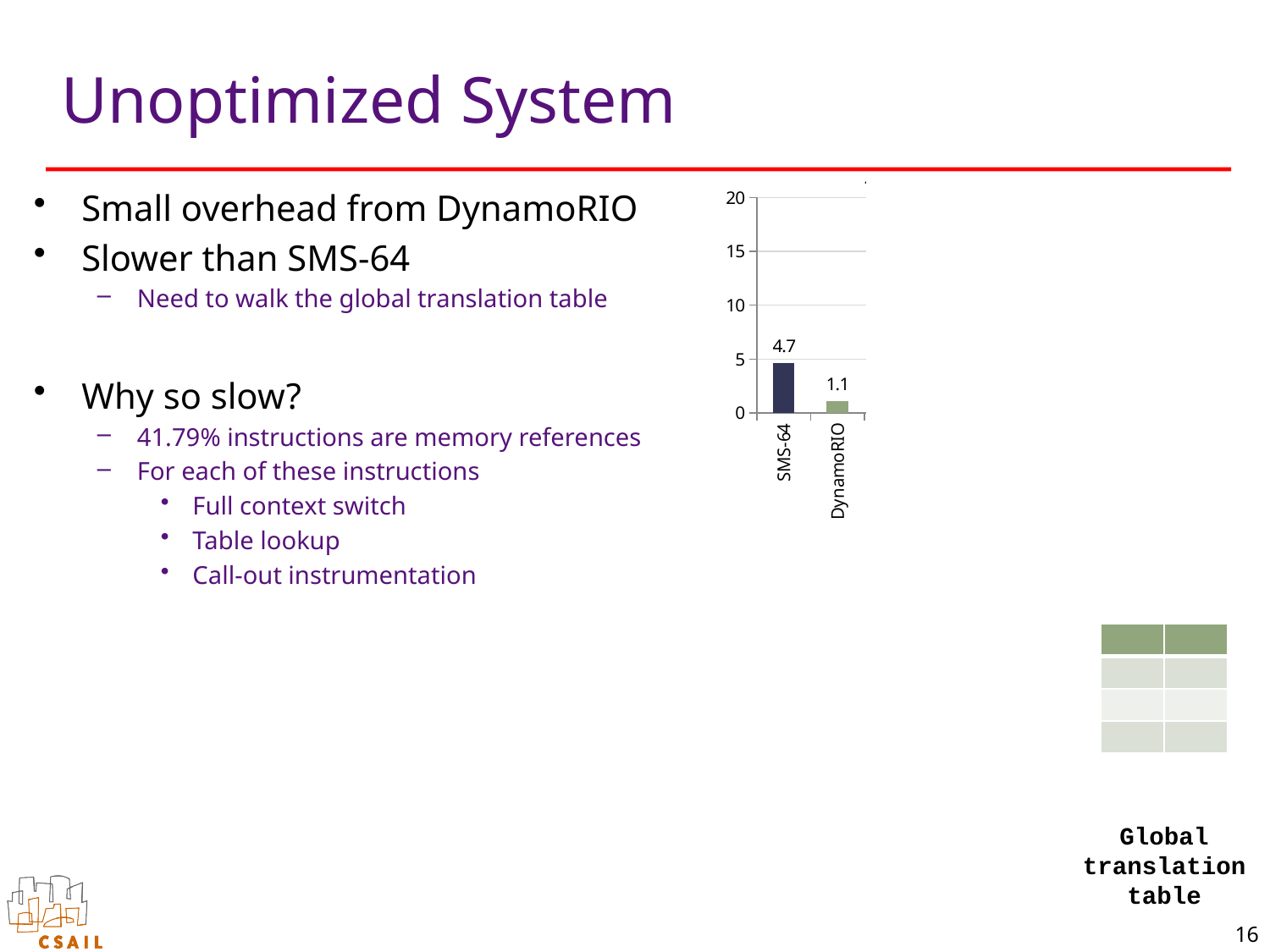
What is the difference between the values for SMS-64 and DynamoRIO? 3.6 What kind of chart is shown on the slide? bar chart What is the value for DynamoRIO in the chart? 1.1 Which category has the lowest value in the chart? DynamoRIO What colour is the bar for SMS-64? dark blue Is the value for SMS-64 greater or less than 5? less Is the value for DynamoRIO greater or less than 5? less Which category has the highest value in the chart? SMS-64 How many categories are shown in the chart? 2 Which is larger, the value for SMS-64 or the value for DynamoRIO? SMS-64 What is the value for SMS-64 in the chart? 4.7 What is the maximum value shown on the chart's vertical axis? 20